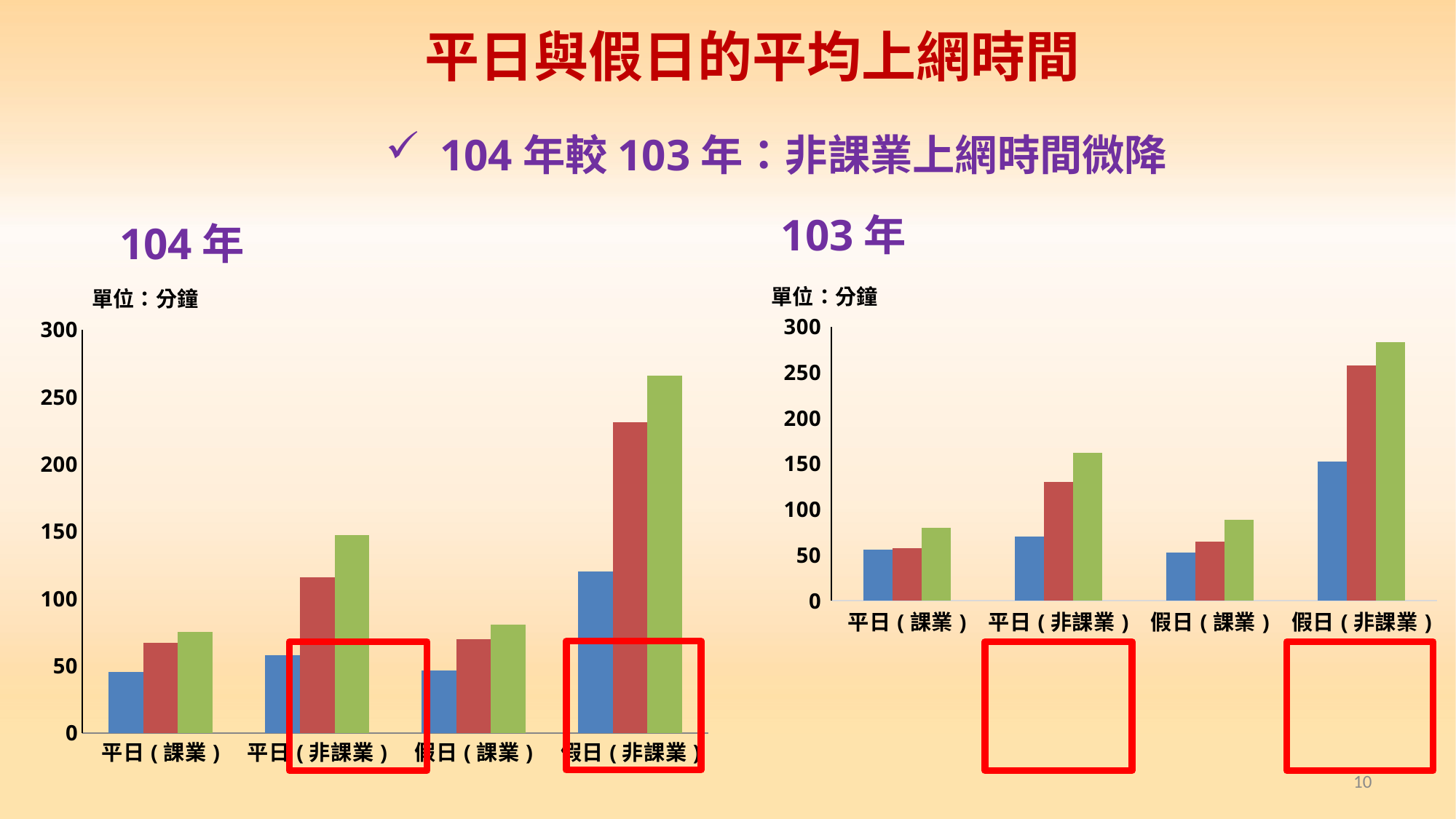
What unit is stated above the 104 年 chart? 分鐘 What kind of chart is the 104 年 chart on the left? bar chart How many categories are shown on the x axis of the 104 年 chart? 4 In the 103 年 chart, which is larger: the green bar for 平日（非課業） or the green bar for 假日（課業）? 平日（非課業） In the 103 年 chart, is the blue bar for 假日（非課業） greater or less than 100? greater In the 104 年 chart, which is larger: the blue bar for 假日（非課業） or the blue bar for 平日（非課業）? 假日（非課業） In the 104 年 chart, which category has the tallest bar? 假日（非課業） In the 103 年 chart, which category has the tallest bar? 假日（非課業） How many bars are plotted for each category in the 103 年 chart? 3 In the 104 年 chart, is the red bar for 平日（非課業） greater or less than 100? greater In the 104 年 chart, is the green bar for 假日（非課業） greater or less than 250? greater